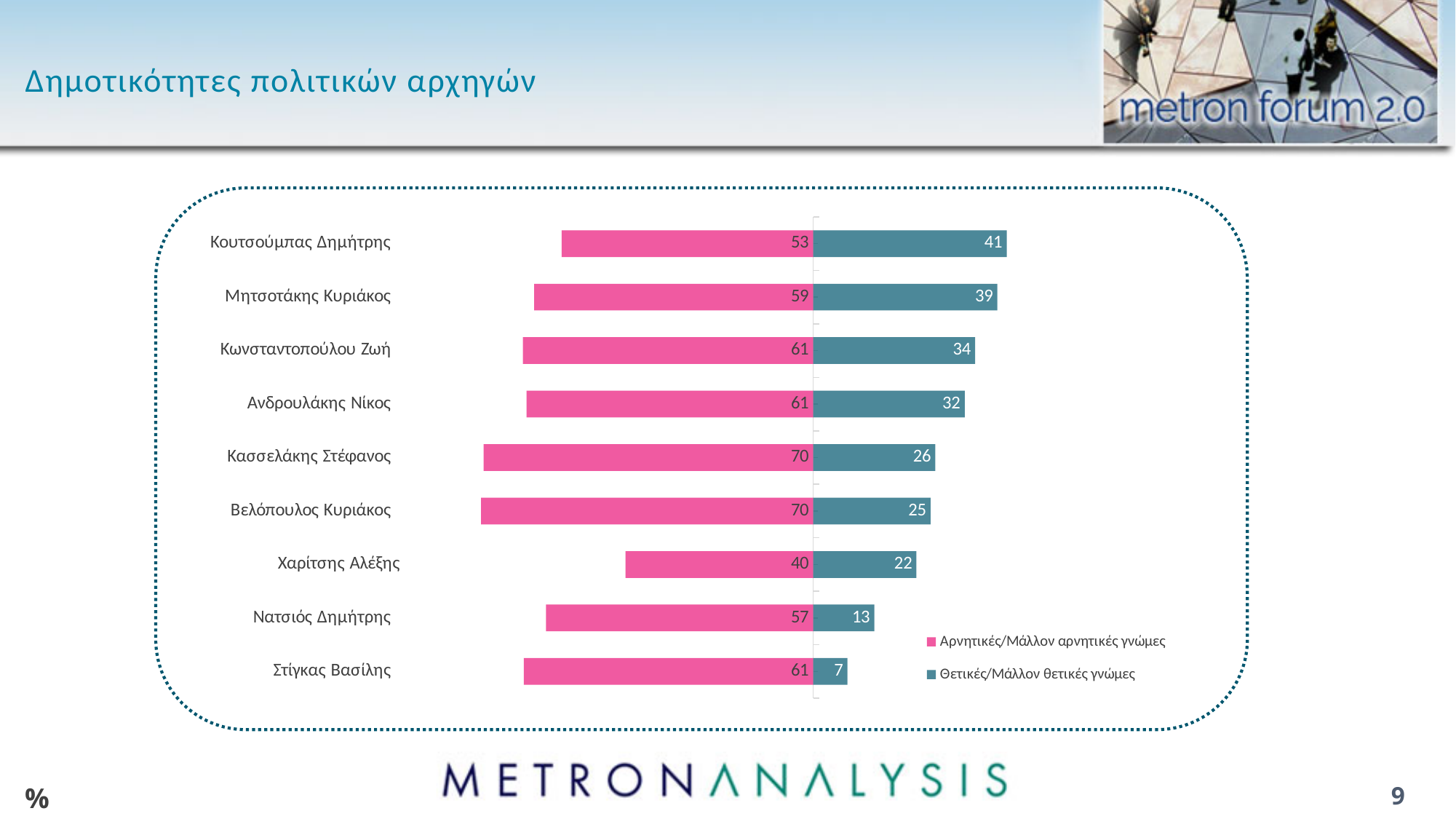
What kind of chart is shown on the slide? Bar chart Which leader has the highest value for Θετικές/Μάλλον θετικές γνώμες? Κουτσούμπας Δημήτρης How many series does the legend list? 2 What is the value of Θετικές/Μάλλον θετικές γνώμες for Στίγκας Βασίλης? 7 Which colour represents Αρνητικές/Μάλλον αρνητικές γνώμες in the chart? Pink Which leader has the lowest value for Αρνητικές/Μάλλον αρνητικές γνώμες? Χαρίτσης Αλέξης What is the value of Αρνητικές/Μάλλον αρνητικές γνώμες for Κασσελάκης Στέφανος? 70 What is the difference between the Αρνητικές/Μάλλον αρνητικές γνώμες and Θετικές/Μάλλον θετικές γνώμες values for Μητσοτάκης Κυριάκος? 20 Which is larger: the Θετικές/Μάλλον θετικές γνώμες value for Ανδρουλάκης Νίκος or for Κωνσταντοπούλου Ζωή? Κωνσταντοπούλου Ζωή What is the total of the Αρνητικές/Μάλλον αρνητικές γνώμες and Θετικές/Μάλλον θετικές γνώμες values for Νατσιός Δημήτρης? 70 How many political leaders are shown in the chart? 9 What is the value of Θετικές/Μάλλον θετικές γνώμες for Κουτσούμπας Δημήτρης? 41